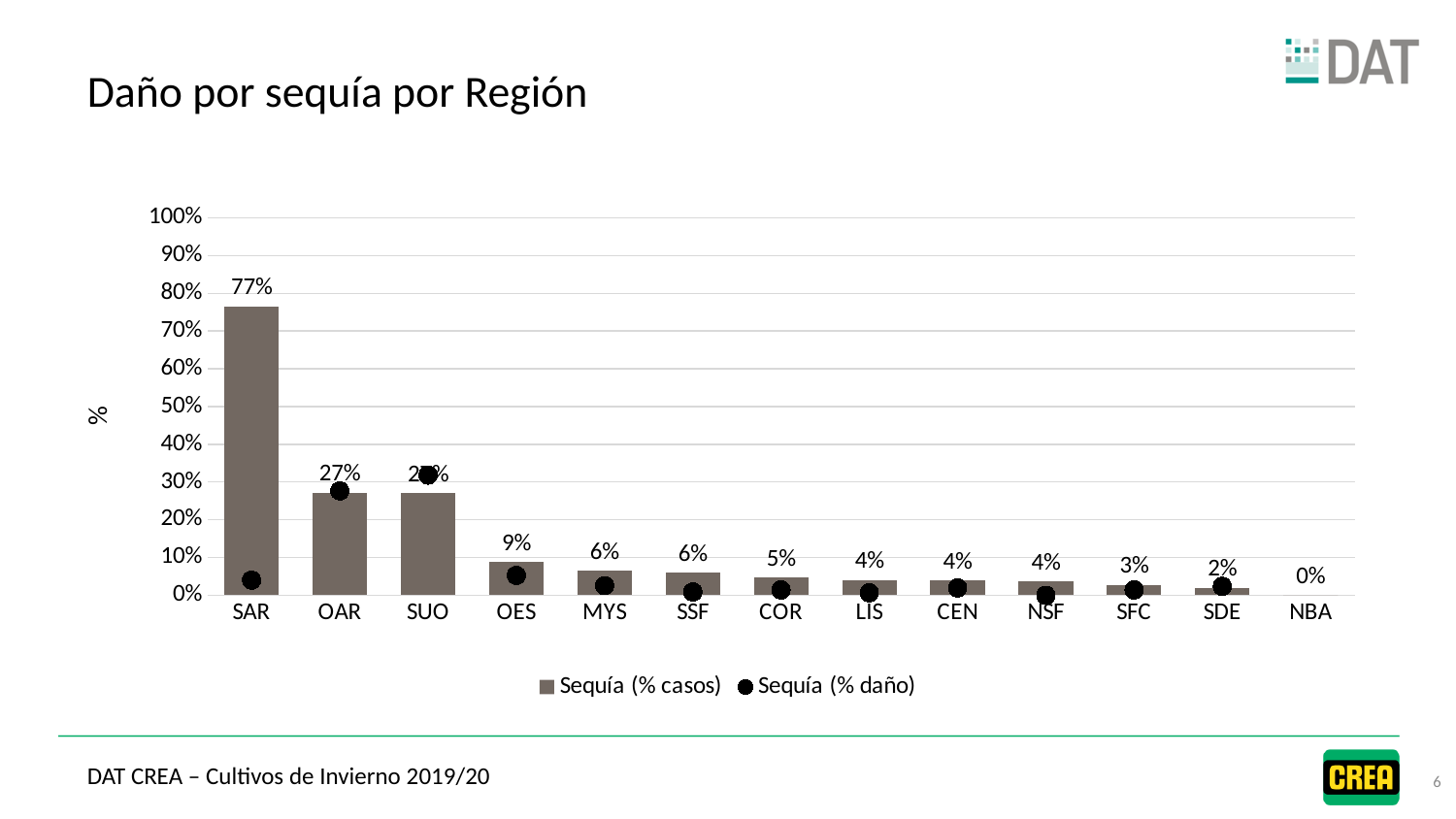
What is the difference between the Sequía (% casos) values for SAR and OAR? 50% How many series does the legend list? 2 Do the Sequía (% casos) bars rise or fall from left to right along the x axis? fall Is the Sequía (% daño) value for SUO greater or less than 20%? greater Which region has the highest Sequía (% casos) value? SAR Is the Sequía (% daño) value for SAR greater or less than 10%? less How many regions are shown on the x axis? 13 Which has a larger Sequía (% casos) value, OAR or OES? OAR What is the value of Sequía (% casos) for SAR? 77% Which region has the lowest Sequía (% casos) value? NBA What is the value of Sequía (% casos) for OES? 9% What is the value of Sequía (% casos) for SDE? 2%